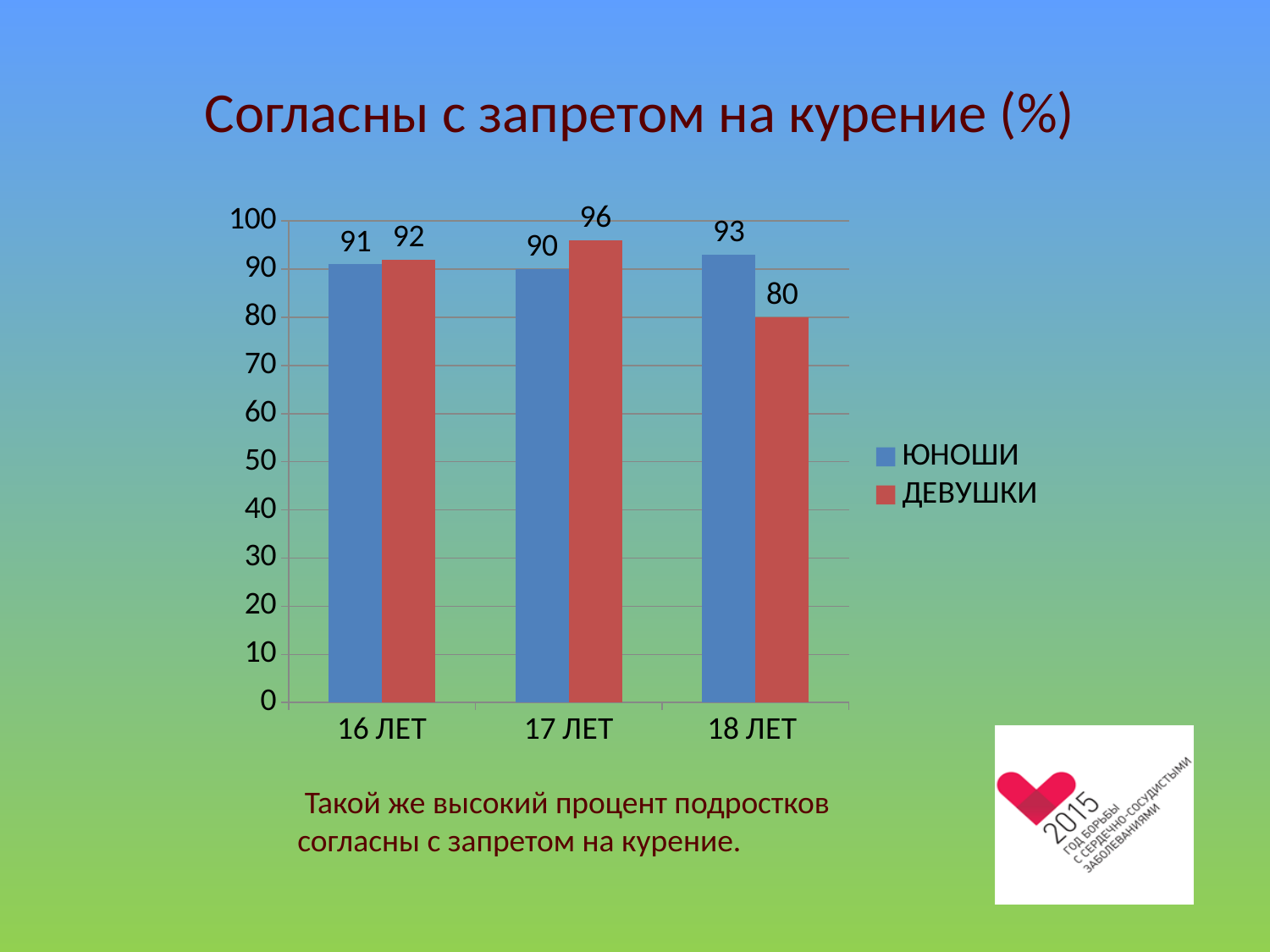
Which age group has the highest value for ДЕВУШКИ? 17 ЛЕТ How many age groups are shown on the x axis? 3 What is the value for ДЕВУШКИ at 17 ЛЕТ? 96 What is the title of the chart? Согласны с запретом на курение (%) What is the value for ДЕВУШКИ at 18 ЛЕТ? 80 What kind of chart is shown on the slide? bar chart How many series does the legend list? 2 What is the value for ЮНОШИ at 16 ЛЕТ? 91 Which is larger at 17 ЛЕТ: ЮНОШИ or ДЕВУШКИ? ДЕВУШКИ Which age group has the lowest value for ДЕВУШКИ? 18 ЛЕТ What is the difference between ЮНОШИ and ДЕВУШКИ at 18 ЛЕТ? 13 What is the difference between ДЕВУШКИ at 17 ЛЕТ and ДЕВУШКИ at 18 ЛЕТ? 16